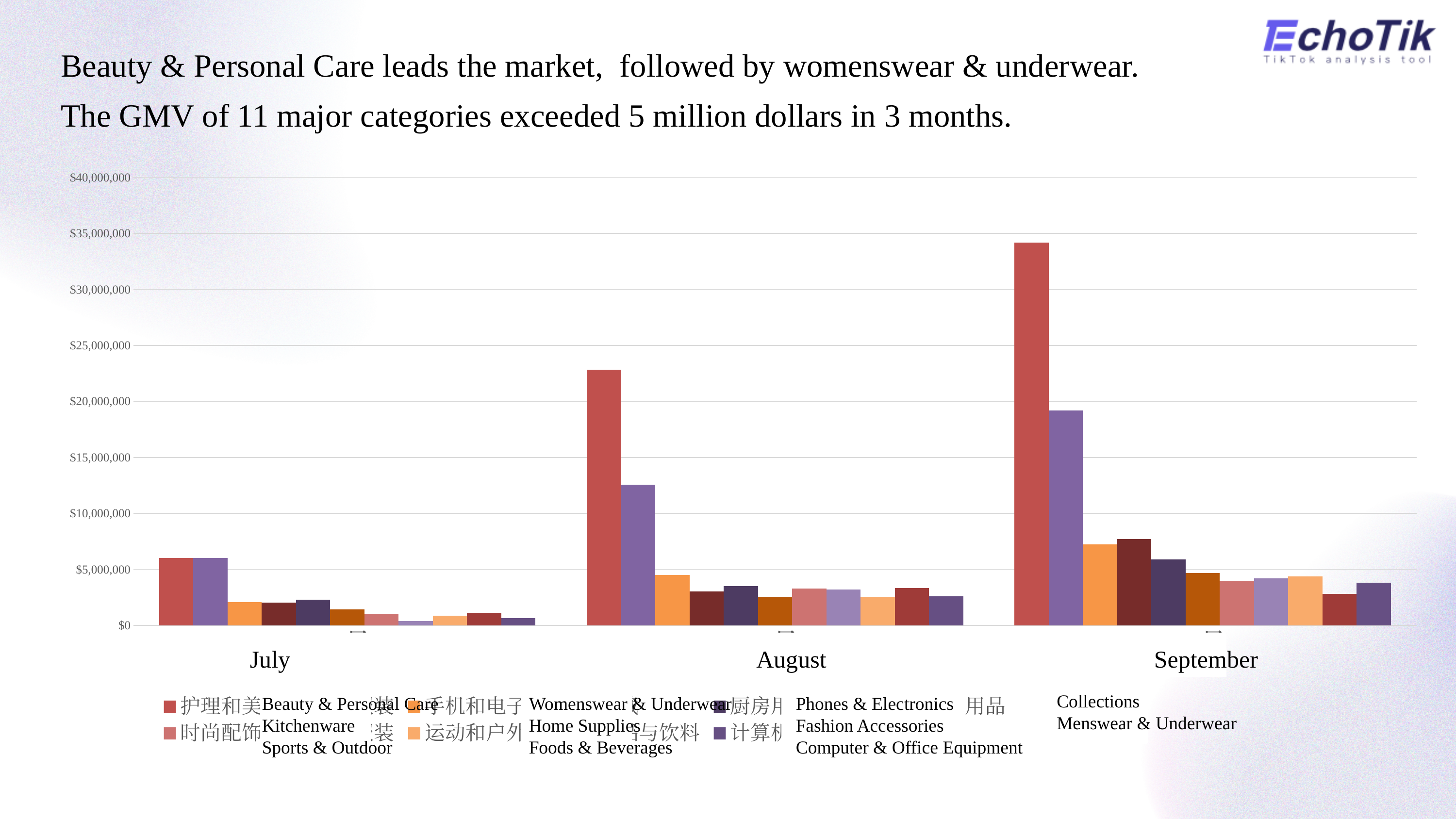
Is the second-tallest bar in August greater or less than $15,000,000? less What kind of chart is shown on the slide? bar chart Does the height of the tallest bar rise or fall from July to September? rise Is the tallest bar in July greater or less than $10,000,000? less Is the tallest bar in August greater or less than $20,000,000? greater How many month groups are shown on the x axis of the chart? 3 Which months are shown on the x axis of the chart? July, August, September Which month has the larger tallest bar, August or September? September In which month does the chart's tallest bar appear? September How many bars are plotted in each month group of the chart? 11